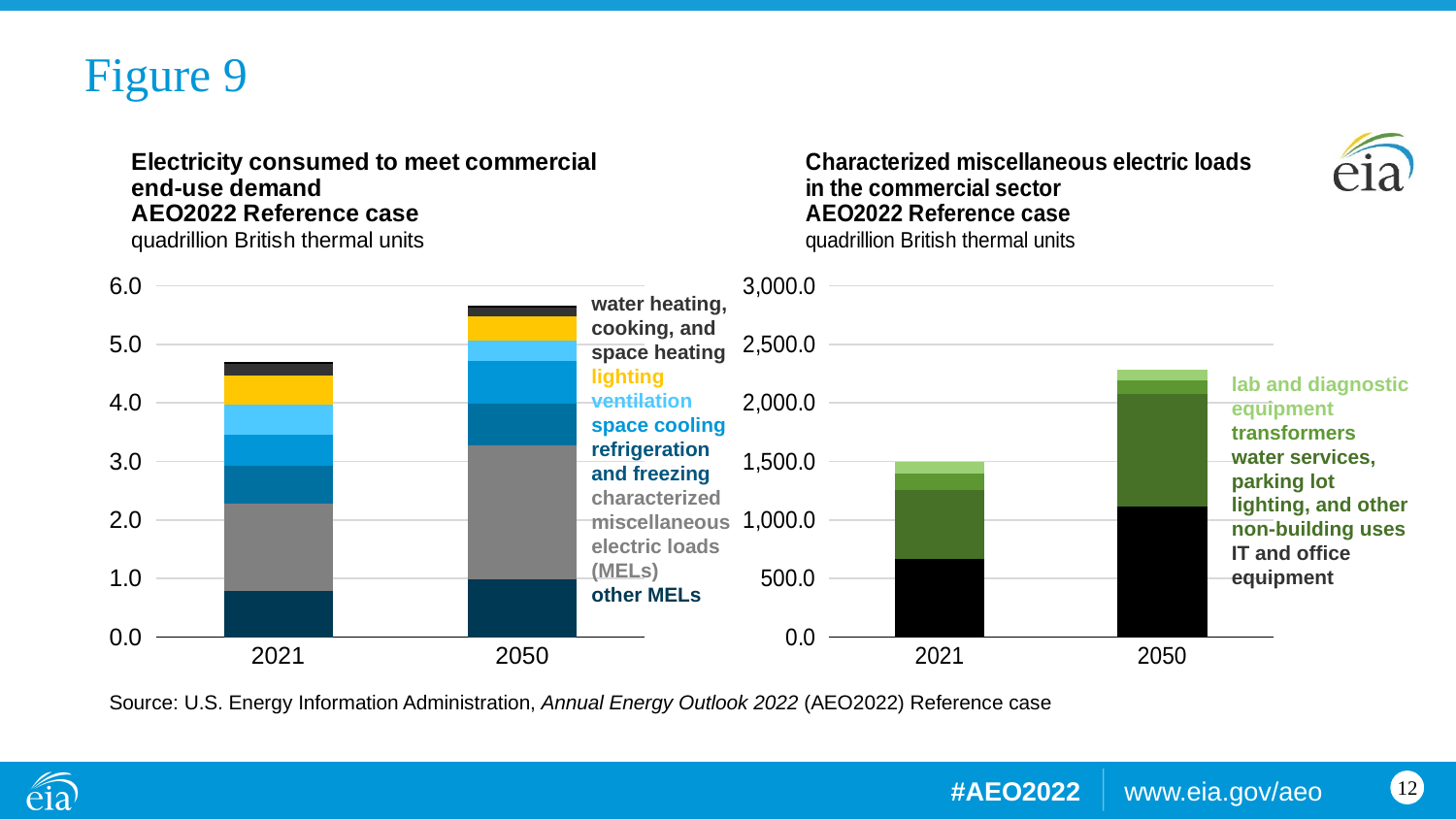
What kind of chart is the left chart, 'Electricity consumed to meet commercial end-use demand'? stacked bar chart In the right chart, 'Characterized miscellaneous electric loads in the commercial sector', is the total for 2050 greater or less than 2,000.0? greater In the left chart, 'Electricity consumed to meet commercial end-use demand', which year has the taller total bar, 2021 or 2050? 2050 In the left chart, 'Electricity consumed to meet commercial end-use demand', does total electricity consumption rise or fall from 2021 to 2050? rise In the right chart, 'Characterized miscellaneous electric loads in the commercial sector', how many series does the legend list? 4 In the left chart, 'Electricity consumed to meet commercial end-use demand', is the total for 2021 greater or less than 4.0? greater What unit is used on the y axis of both charts? quadrillion British thermal units In the right chart, 'Characterized miscellaneous electric loads in the commercial sector', is the value for IT and office equipment in 2050 greater or less than 1,000.0? greater In the left chart, 'Electricity consumed to meet commercial end-use demand', how many years are shown on the x axis? 2 In the left chart, 'Electricity consumed to meet commercial end-use demand', how many series does the legend list? 7 In the right chart, 'Characterized miscellaneous electric loads in the commercial sector', which year has the larger total, 2021 or 2050? 2050